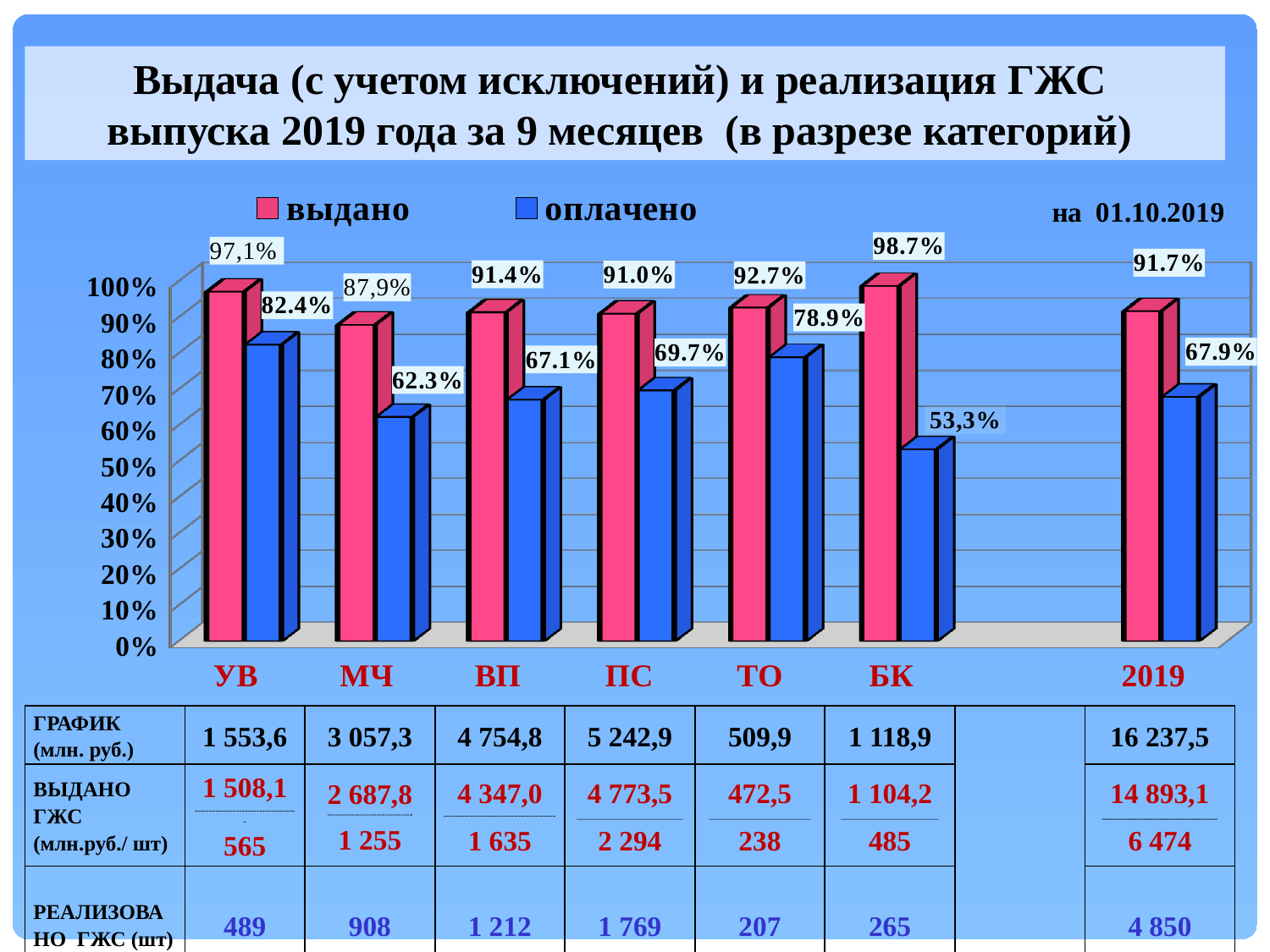
What kind of chart is shown on the slide? bar chart Which category has the highest выдано value? БК How many series does the chart legend list? 2 What is the value of the оплачено series for 2019? 67.9% What is the difference between the выдано and оплачено values for ТО? 13.8% What is the value of the оплачено series for БК? 53,3% What is the value of the выдано series for УВ? 97,1% Which is larger: the оплачено value for МЧ or the оплачено value for ПС? ПС Which category has the lowest оплачено value? БК How many categories are shown on the x axis of the chart? 7 Which category has the highest оплачено value? УВ Is the оплачено value for ВП greater or less than 70%? less